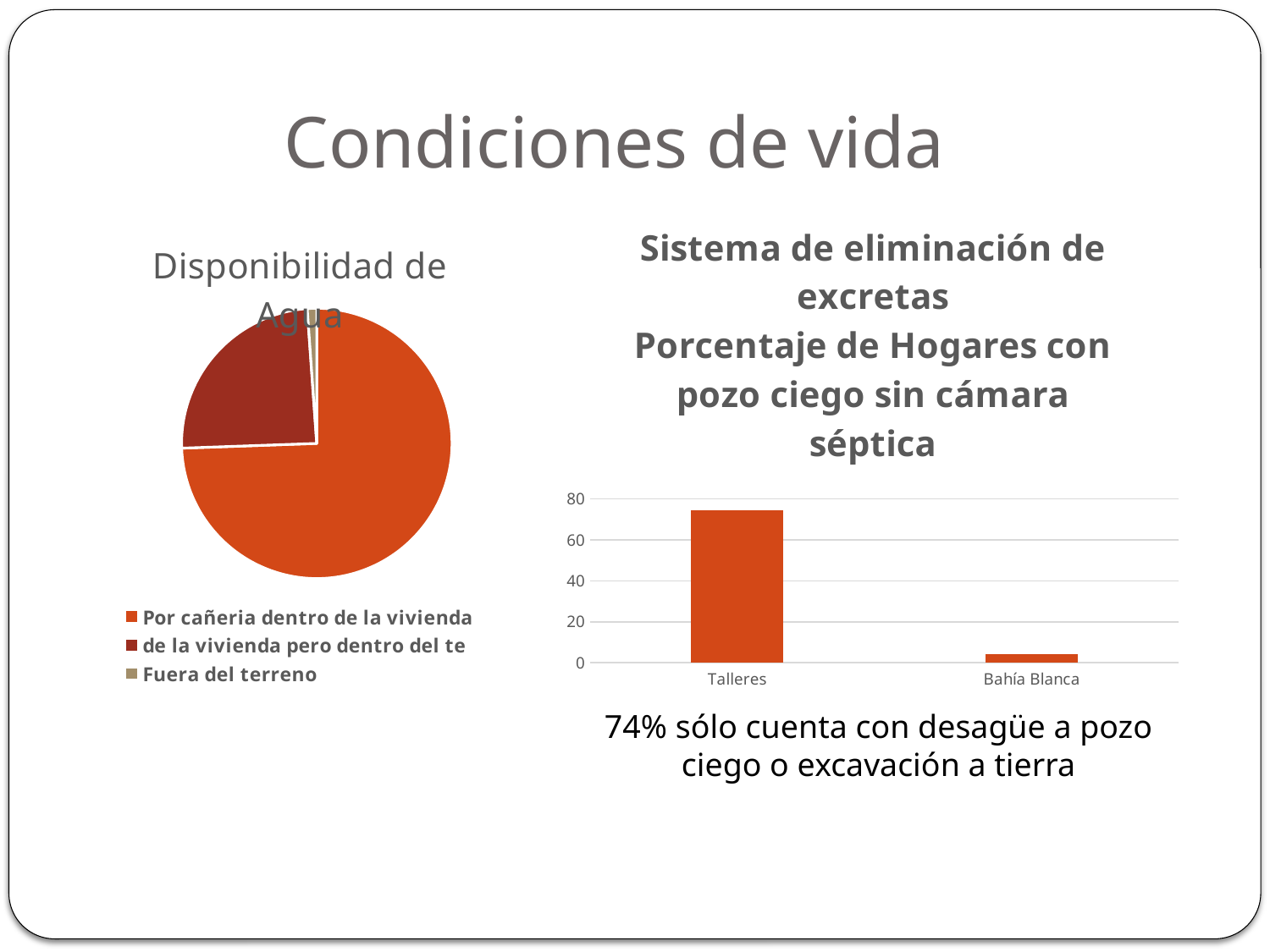
In the "Disponibilidad de Agua" chart, how many categories does the legend list? 3 What kind of chart is the "Disponibilidad de Agua" chart? pie chart What kind of chart is the "Sistema de eliminación de excretas" chart? bar chart In the "Sistema de eliminación de excretas" chart, which category has the highest bar? Talleres In the "Sistema de eliminación de excretas" chart, which is larger, the value for Talleres or the value for Bahía Blanca? Talleres In the "Sistema de eliminación de excretas" chart, is the value for Talleres greater or less than 60? greater In the "Sistema de eliminación de excretas" chart, is the value for Bahía Blanca greater or less than 20? less In the "Sistema de eliminación de excretas" chart, how many categories are shown on the x axis? 2 In the "Disponibilidad de Agua" chart, which category has the largest slice? Por cañeria dentro de la vivienda In the "Sistema de eliminación de excretas" chart, which category has the lowest bar? Bahía Blanca In the "Sistema de eliminación de excretas" chart, what is the highest value shown on the y axis? 80 In the "Disponibilidad de Agua" chart, which category has the smallest slice? Fuera del terreno